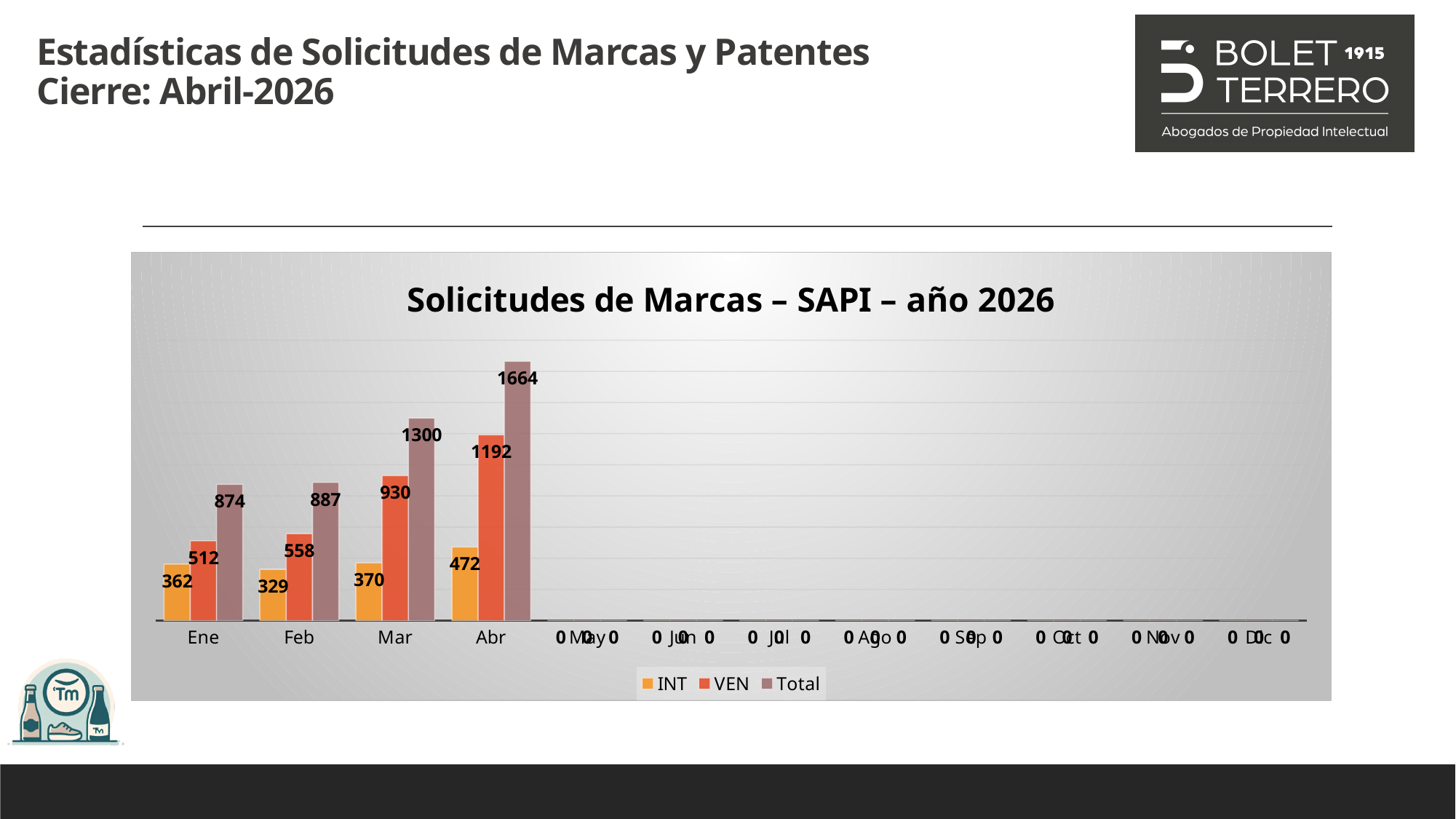
Which is larger, the VEN value for Feb or the VEN value for Ene? VEN value for Feb What is the difference between the VEN and INT values for Ene? 150 How many month categories are shown on the x axis? 12 How many series does the legend list? 3 What is the VEN value for Mar? 930 Among the months with non-zero data (Ene to Abr), which month has the lowest INT value? Feb What kind of chart is shown on the slide? Bar chart What is the title of the chart? Solicitudes de Marcas – SAPI – año 2026 What is the INT value for Feb? 329 What is the difference between the Total values for Abr and Mar? 364 Which month has the highest Total value? Abr What is the value of the Total series for Abr? 1664